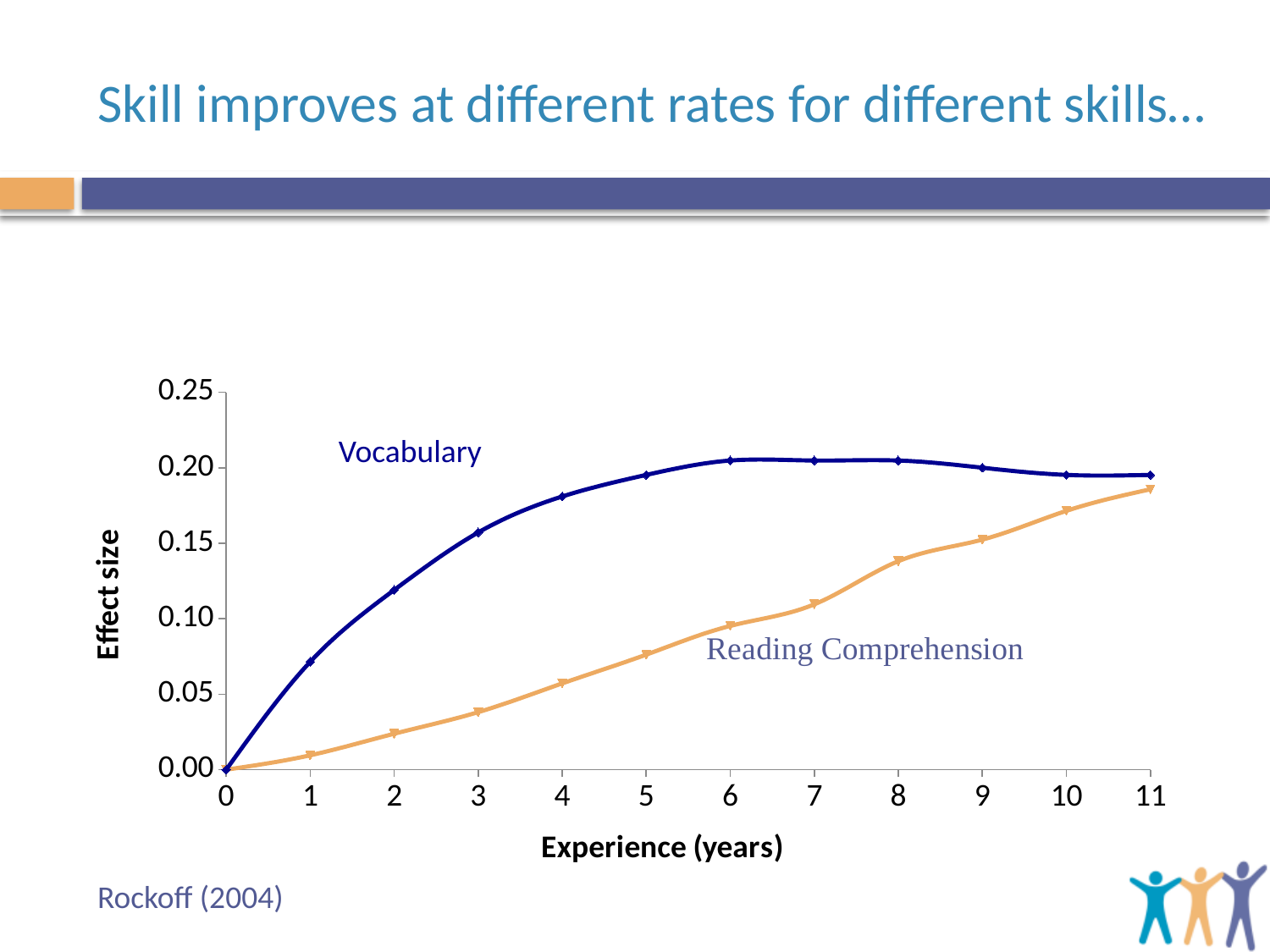
At which number of years of experience is the Reading Comprehension effect size highest? 11 How many data points does the Vocabulary line have? 12 At 3 years of experience, which series has the larger effect size, Vocabulary or Reading Comprehension? Vocabulary Does the Reading Comprehension effect size rise or fall as experience increases from 0 to 11 years? rise Is the Reading Comprehension effect size at 11 years of experience greater or less than 0.20? less Is the Vocabulary effect size at 1 year of experience greater or less than 0.05? greater Is the Reading Comprehension effect size at 8 years of experience greater or less than 0.15? less How many series are plotted on the chart? 2 What kind of chart is shown on the slide? line chart What is the label of the x axis of the chart? Experience (years) What is the effect size for Reading Comprehension at 0 years of experience? 0.00